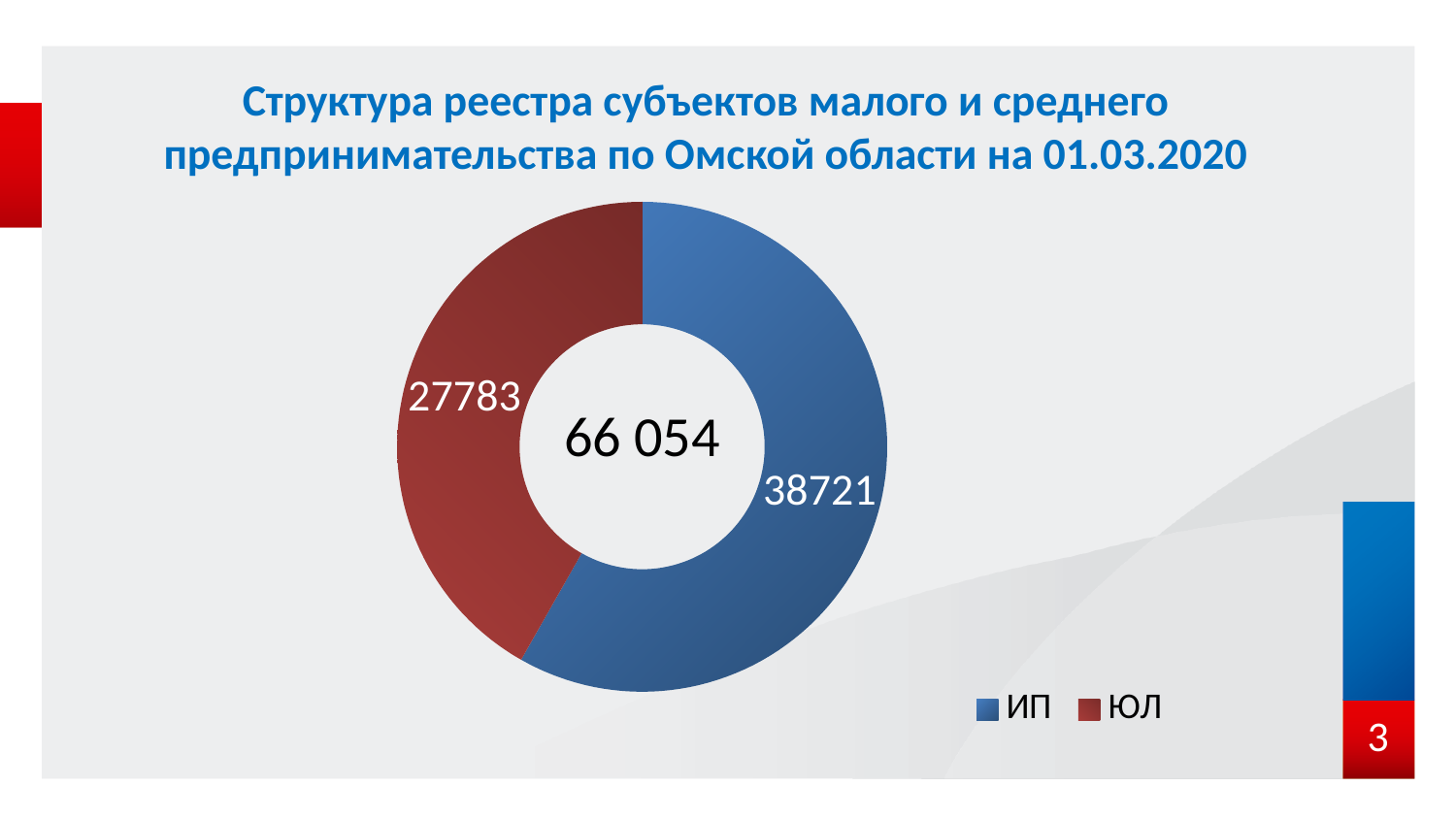
How many entries does the legend list? 2 What is the difference between the values for ИП and ЮЛ? 10938 Which category has the largest slice in the chart? ИП What is the value for ИП in the chart? 38721 What is the value for ЮЛ in the chart? 27783 What share of the chart's total (sum of the two printed slice values) does ИП represent? 58.2% Which is larger, the value for ИП or the value for ЮЛ? ИП What kind of chart is shown on the slide? doughnut chart Which category has the smallest slice in the chart? ЮЛ How many categories does the chart show? 2 What number is printed in the centre of the doughnut chart? 66 054 What colour is the ЮЛ slice in the chart? red